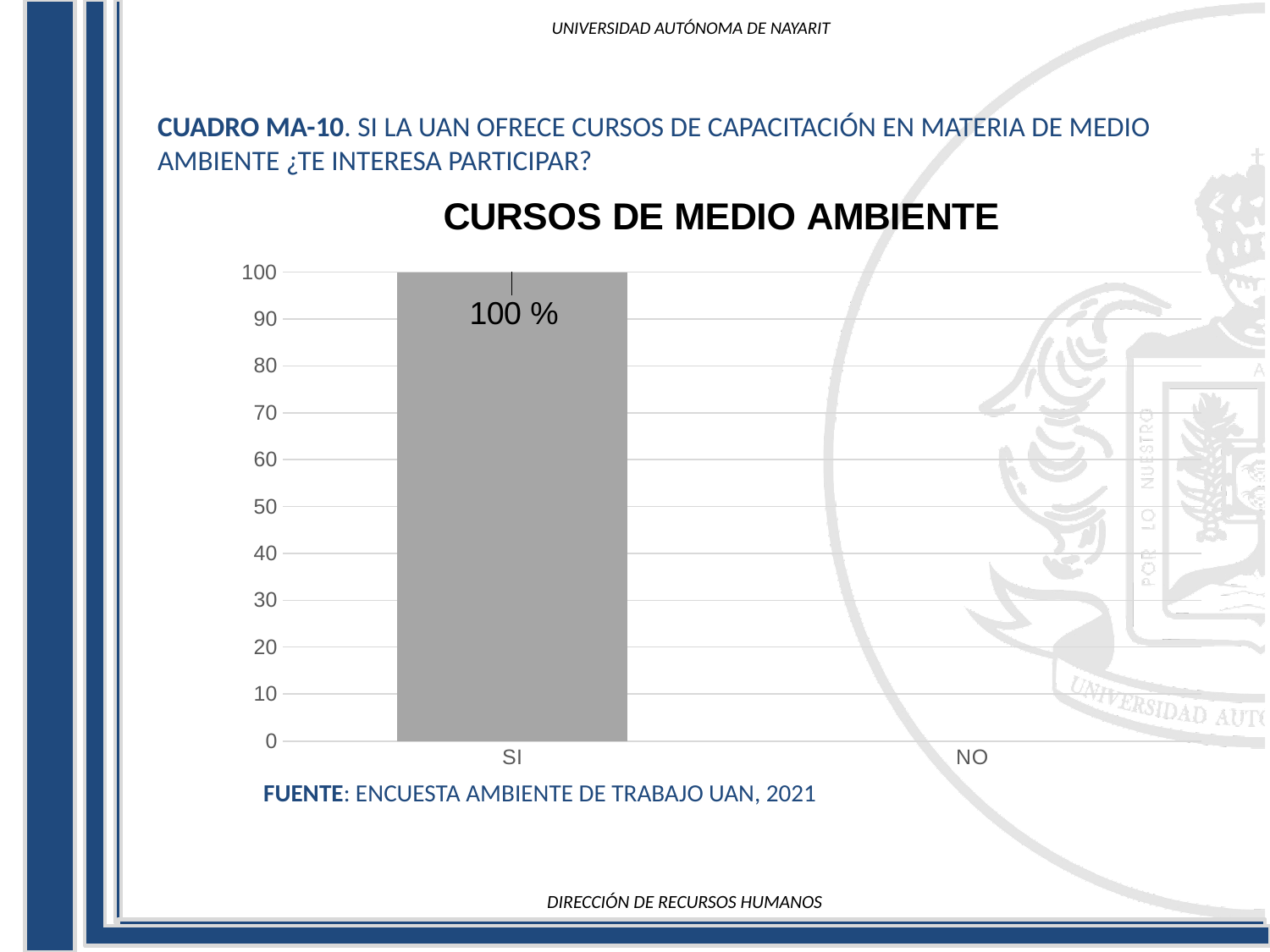
What is the highest value marked on the vertical axis of the chart? 100 How many categories are shown on the x axis of the chart? 2 Is the value for NO greater or less than 10? less What is the title of the chart? CURSOS DE MEDIO AMBIENTE Is the value for SI greater or less than 50? greater Which category has the lowest value in the chart? NO Which is larger, the value for SI or the value for NO? SI What is the value shown for SI in the CURSOS DE MEDIO AMBIENTE chart? 100 % What kind of chart is shown on the slide? Bar chart Which category has the highest value in the chart? SI